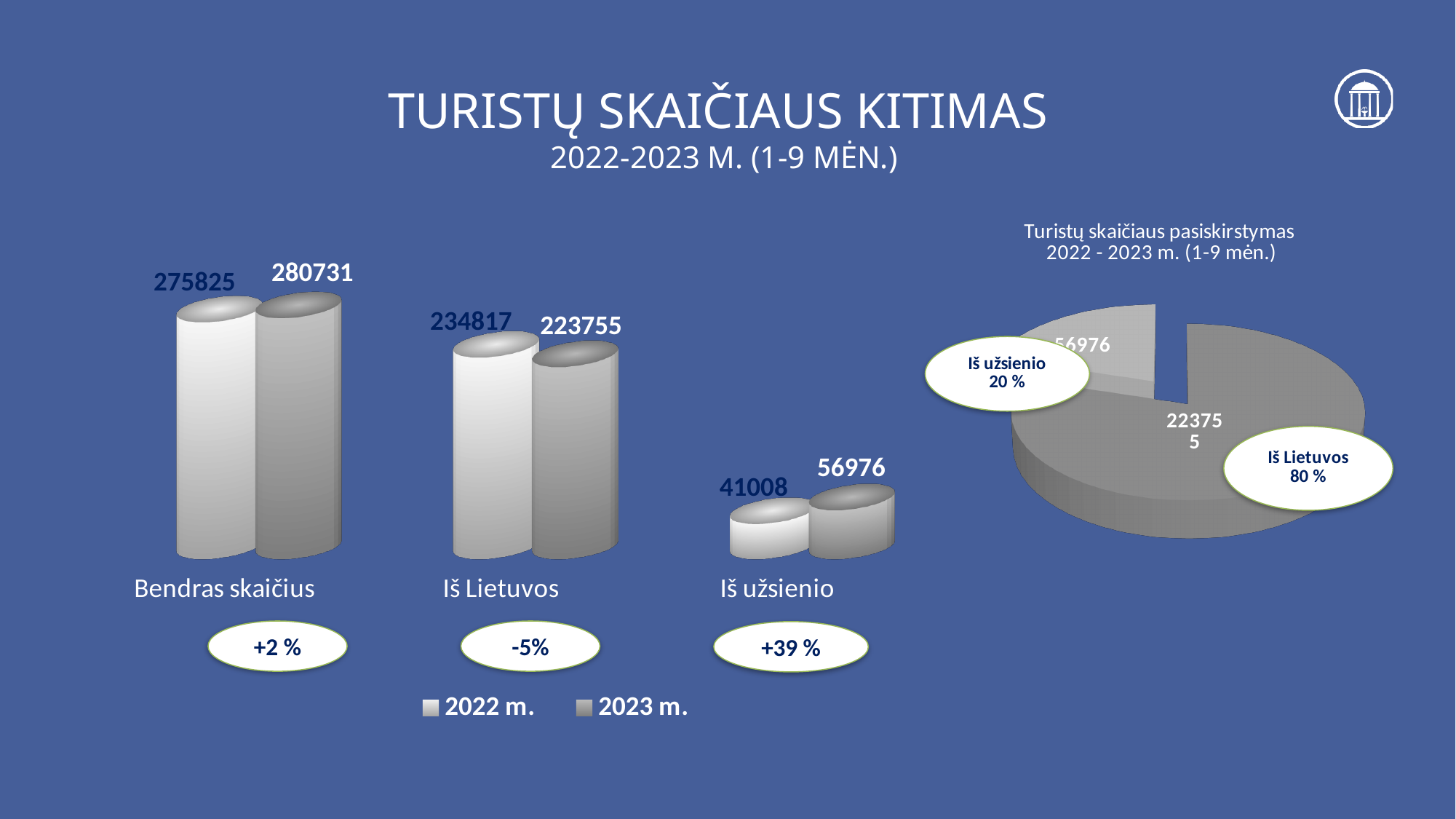
In the pie chart on the right, what share of the pie does Iš Lietuvos have? 80 % In the bar chart on the left, which is larger for Iš Lietuvos: the 2022 m. value or the 2023 m. value? 2022 m. How many series does the legend of the bar chart on the left list? 2 In the bar chart on the left, what is the value for Iš užsienio in 2023 m.? 56976 In the bar chart on the left, what is the value for Bendras skaičius in 2023 m.? 280731 In the bar chart on the left, which category has the highest value in 2023 m.? Bendras skaičius In the bar chart on the left, which category has the lowest value in 2022 m.? Iš užsienio In the bar chart on the left, what is the difference between the 2023 m. and 2022 m. values for Iš užsienio? 15968 What kind of chart is the chart on the right of the slide? Pie chart What is the title of the pie chart on the right? Turistų skaičiaus pasiskirstymas 2022 - 2023 m. (1-9 mėn.) In the bar chart on the left, what is the value for Iš Lietuvos in 2022 m.? 234817 How many categories are shown in the bar chart on the left? 3